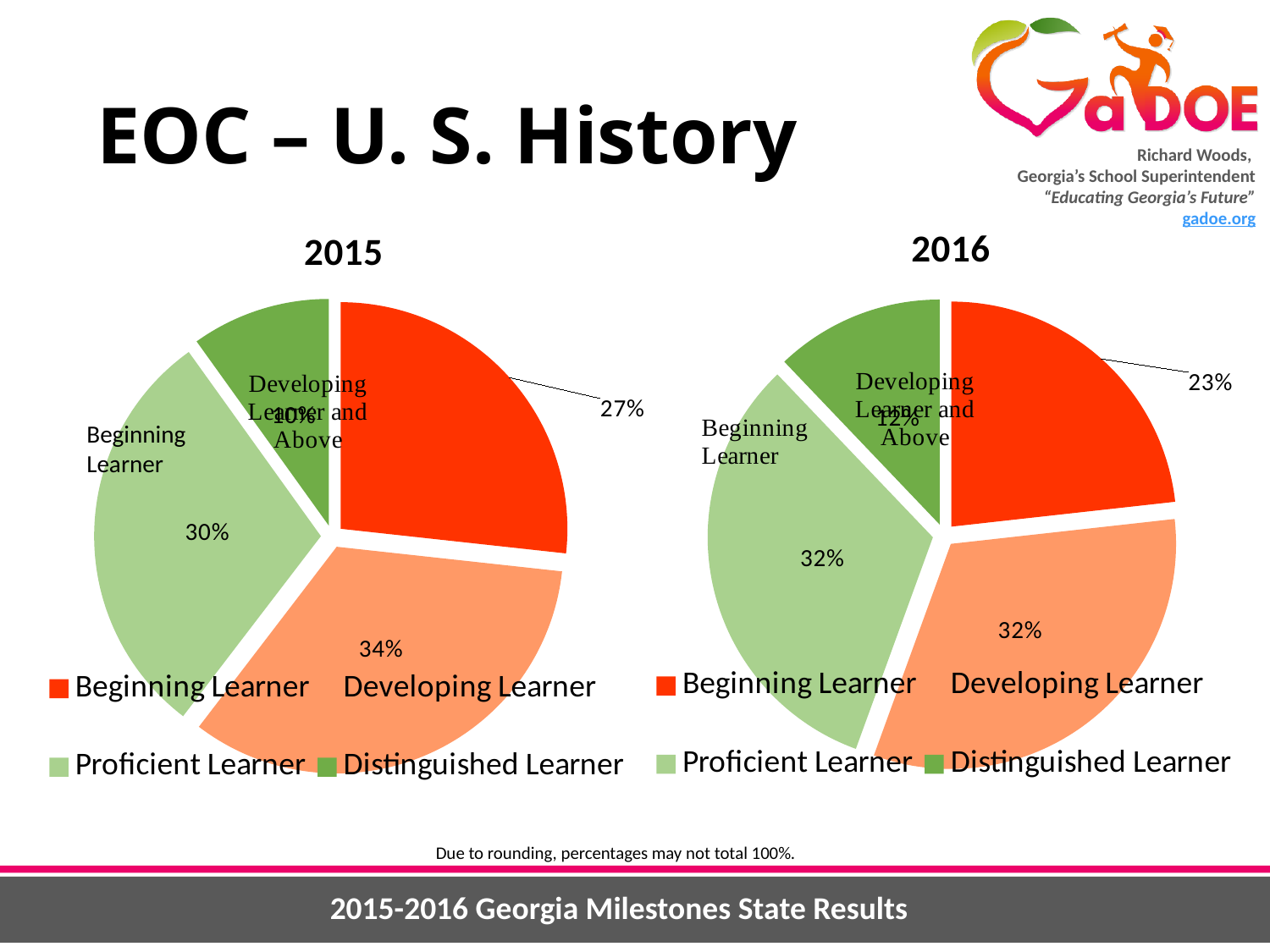
In the 2015 pie chart, what percentage is shown for Developing Learner? 34% How many categories does the legend of the 2016 pie chart list? 4 What is the difference between the Beginning Learner percentage in 2015 and in 2016? 4 percentage points What type of chart is used for the 2015 and 2016 results? Pie chart In the 2015 pie chart, which category has the largest share? Developing Learner In the 2016 pie chart, what percentage is shown for Beginning Learner? 23% In the 2016 pie chart, which category has the smallest share? Distinguished Learner In the 2015 pie chart, what percentage is shown for Beginning Learner? 27% In the 2016 pie chart, what percentage is shown for Developing Learner? 32% In the 2016 pie chart, what percentage is shown for Proficient Learner? 32% In the 2015 pie chart, what percentage is shown for Proficient Learner? 30% Which is larger: the Developing Learner share in 2015 or the Developing Learner share in 2016? 2015